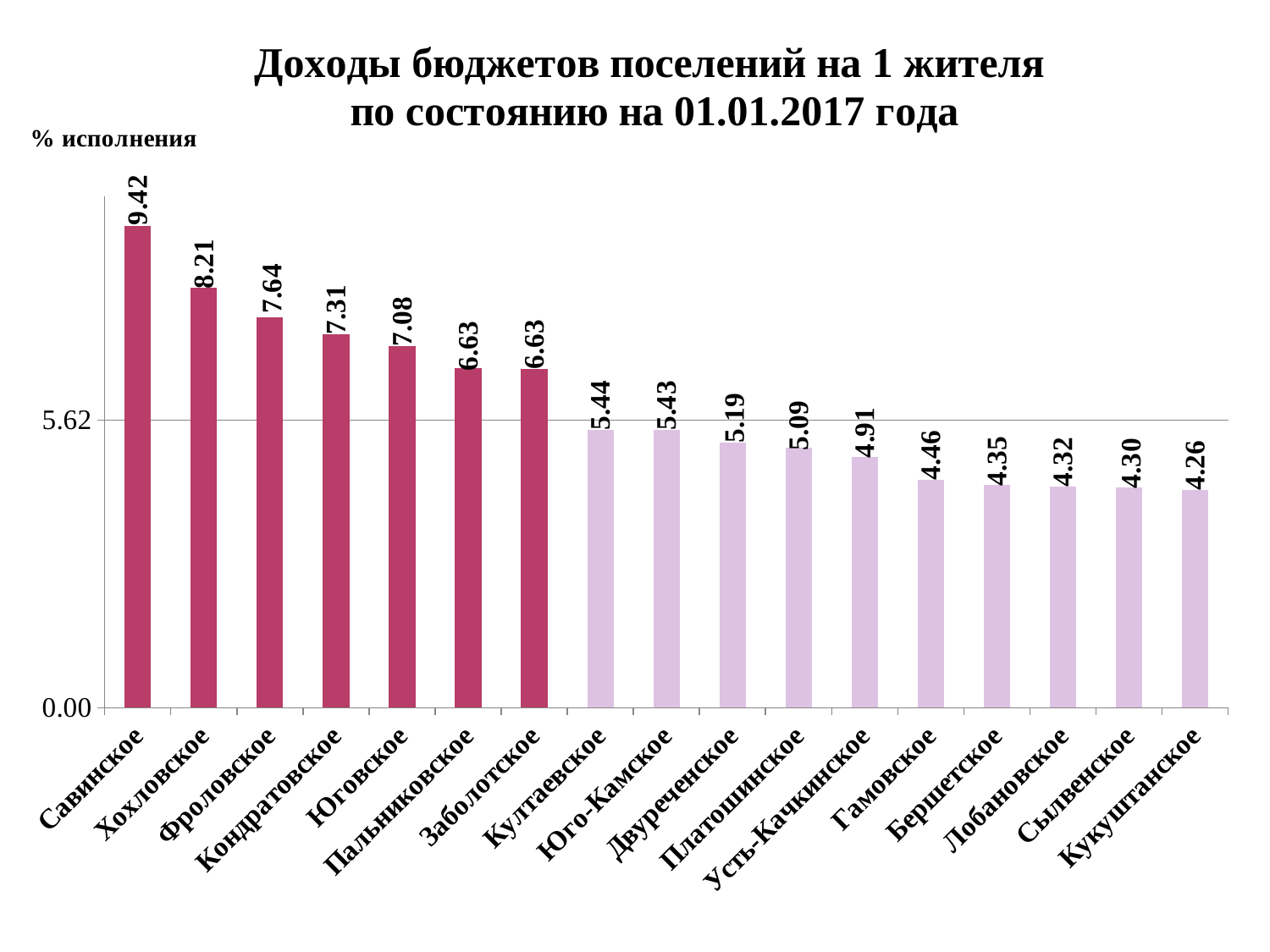
What is the title of the chart? Доходы бюджетов поселений на 1 жителя по состоянию на 01.01.2017 года Which settlement has the highest value? Савинское What is the value for Платошинское? 5.09 What is the difference between the values for Савинское and Хохловское? 1.21 Which settlement has the lowest value? Кукуштанское Is the value for Юговское greater or less than 5.62? greater What is the value for Савинское? 9.42 What kind of chart is shown on the slide? bar chart What is the value for Кукуштанское? 4.26 Which is larger, the value for Фроловское or the value for Гамовское? Фроловское Do the values rise or fall from left to right along the x axis? fall How many settlements are shown on the chart? 17